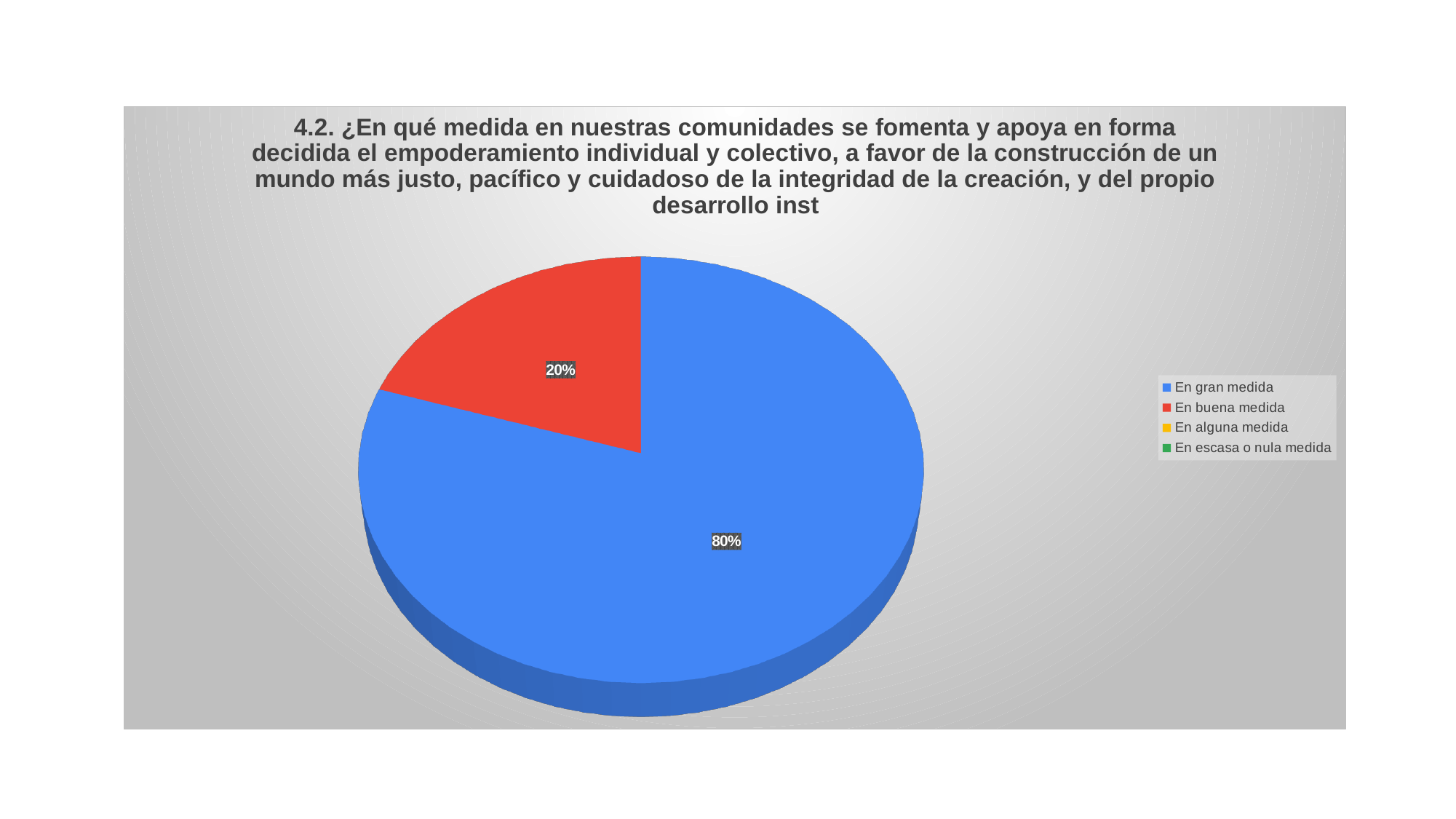
Which category has the largest slice of the pie? En gran medida Which legend entry is shown in blue? En gran medida What is the combined share of the "En gran medida" and "En buena medida" slices? 100% How many categories does the legend list? 4 How many slices are visible in the pie? 2 What share of the pie does "En gran medida" represent? 80% What share of the pie does "En buena medida" represent? 20% What colour is the "En buena medida" slice? red Which of the two visible slices is larger, "En gran medida" or "En buena medida"? En gran medida What is the difference in percentage points between the "En gran medida" and "En buena medida" slices? 60% What kind of chart is shown on the slide? pie chart